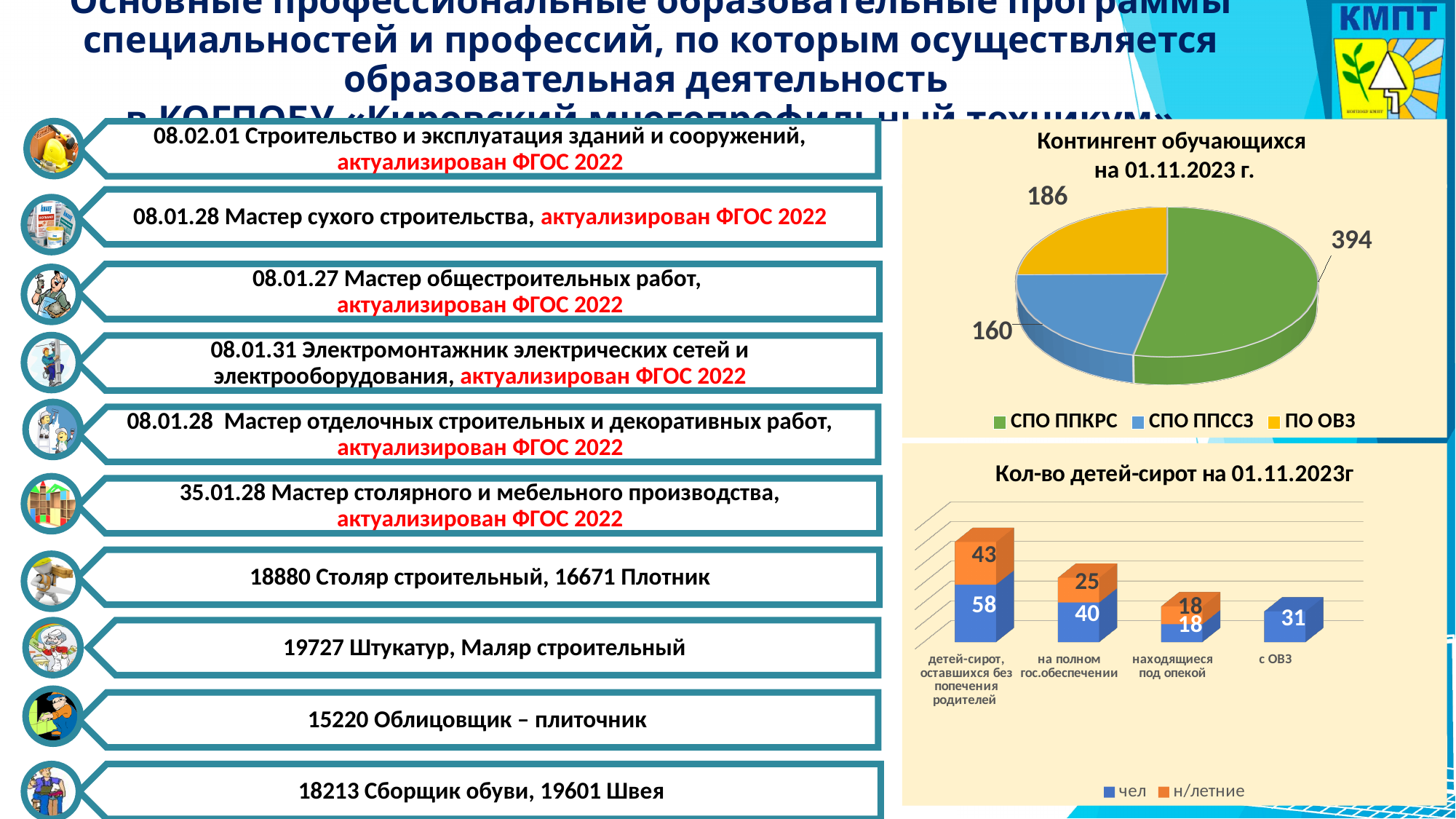
In the pie chart 'Контингент обучающихся на 01.11.2023 г.', which category has the smallest value? СПО ППССЗ What kind of chart is 'Кол-во детей-сирот на 01.11.2023г'? Stacked bar chart In the pie chart 'Контингент обучающихся на 01.11.2023 г.', what is the value for ПО ОВЗ? 186 In the chart 'Кол-во детей-сирот на 01.11.2023г', what is the total of the stacked bar for 'на полном гос.обеспечении'? 65 In the pie chart 'Контингент обучающихся на 01.11.2023 г.', what is the difference between СПО ППКРС and СПО ППССЗ? 234 In the pie chart 'Контингент обучающихся на 01.11.2023 г.', which colour represents ПО ОВЗ? Yellow In the chart 'Кол-во детей-сирот на 01.11.2023г', what is the 'чел' value for 'на полном гос.обеспечении'? 40 In the pie chart 'Контингент обучающихся на 01.11.2023 г.', what is the value for СПО ППКРС? 394 In the chart 'Кол-во детей-сирот на 01.11.2023г', how many series does the legend list? 2 In the pie chart 'Контингент обучающихся на 01.11.2023 г.', how many categories does the legend list? 3 In the chart 'Кол-во детей-сирот на 01.11.2023г', which category has the highest 'чел' value? детей-сирот, оставшихся без попечения родителей In the chart 'Кол-во детей-сирот на 01.11.2023г', what is the 'н/летние' value for 'детей-сирот, оставшихся без попечения родителей'? 43